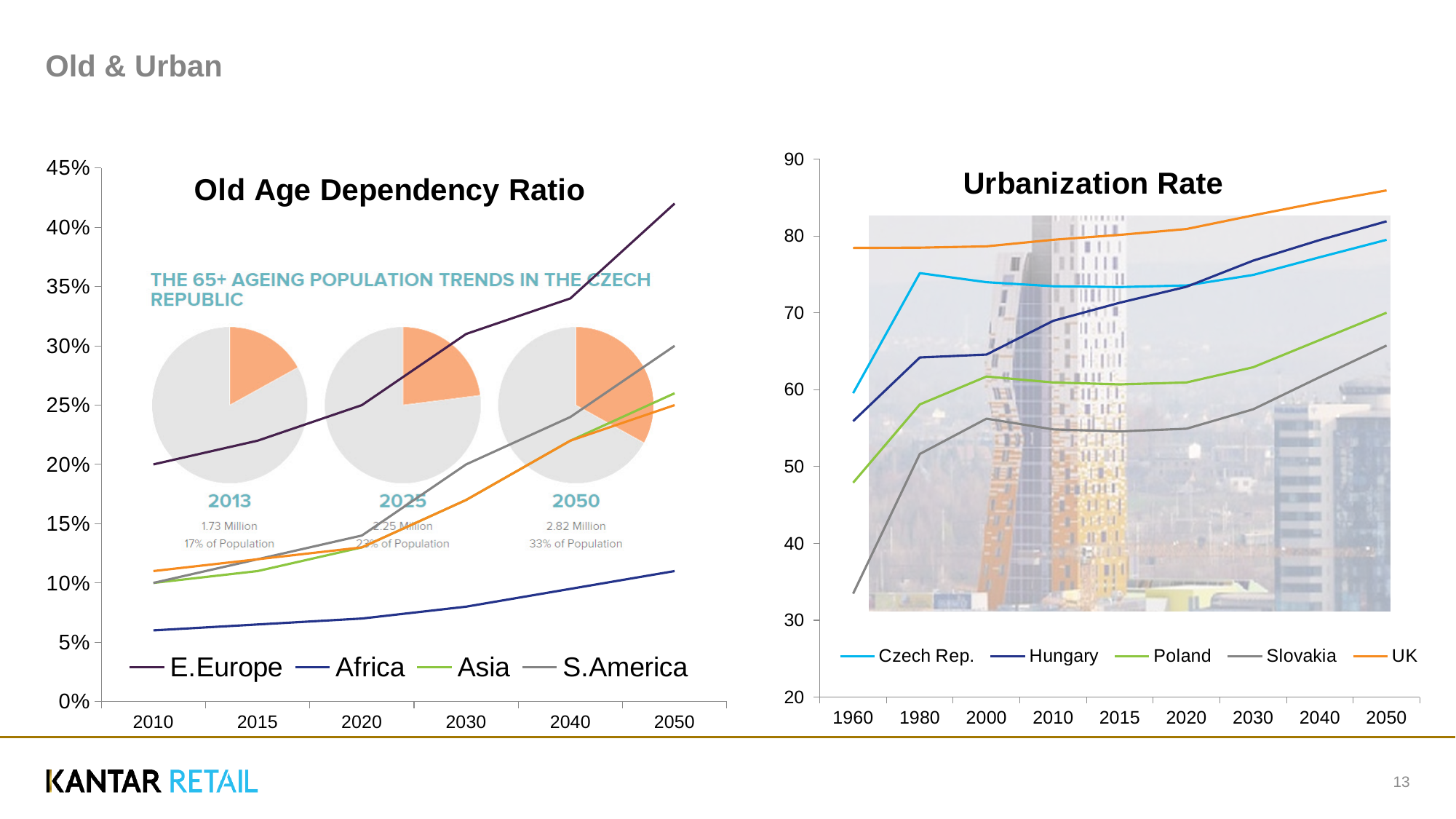
In the Old Age Dependency Ratio chart, is the value for E.Europe in 2050 greater or less than 40%? greater How many series does the legend of the Old Age Dependency Ratio chart list? 4 In the Urbanization Rate chart, which is larger in 2050, Hungary or Poland? Hungary In the Old Age Dependency Ratio chart, which series has the lowest value in 2050? Africa In the Urbanization Rate chart, which country has the lowest value in 1960? Slovakia In the Old Age Dependency Ratio chart, which series has the highest value in 2050? E.Europe What kind of chart is the Old Age Dependency Ratio chart? line chart In the Old Age Dependency Ratio chart, does the E.Europe line rise or fall from 2010 to 2050? rise In the Old Age Dependency Ratio chart, is the value for Africa in 2050 greater or less than 15%? less In the Urbanization Rate chart, which country has the highest value in 1960? UK How many years are shown on the x axis of the Urbanization Rate chart? 9 How many series does the legend of the Urbanization Rate chart list? 5